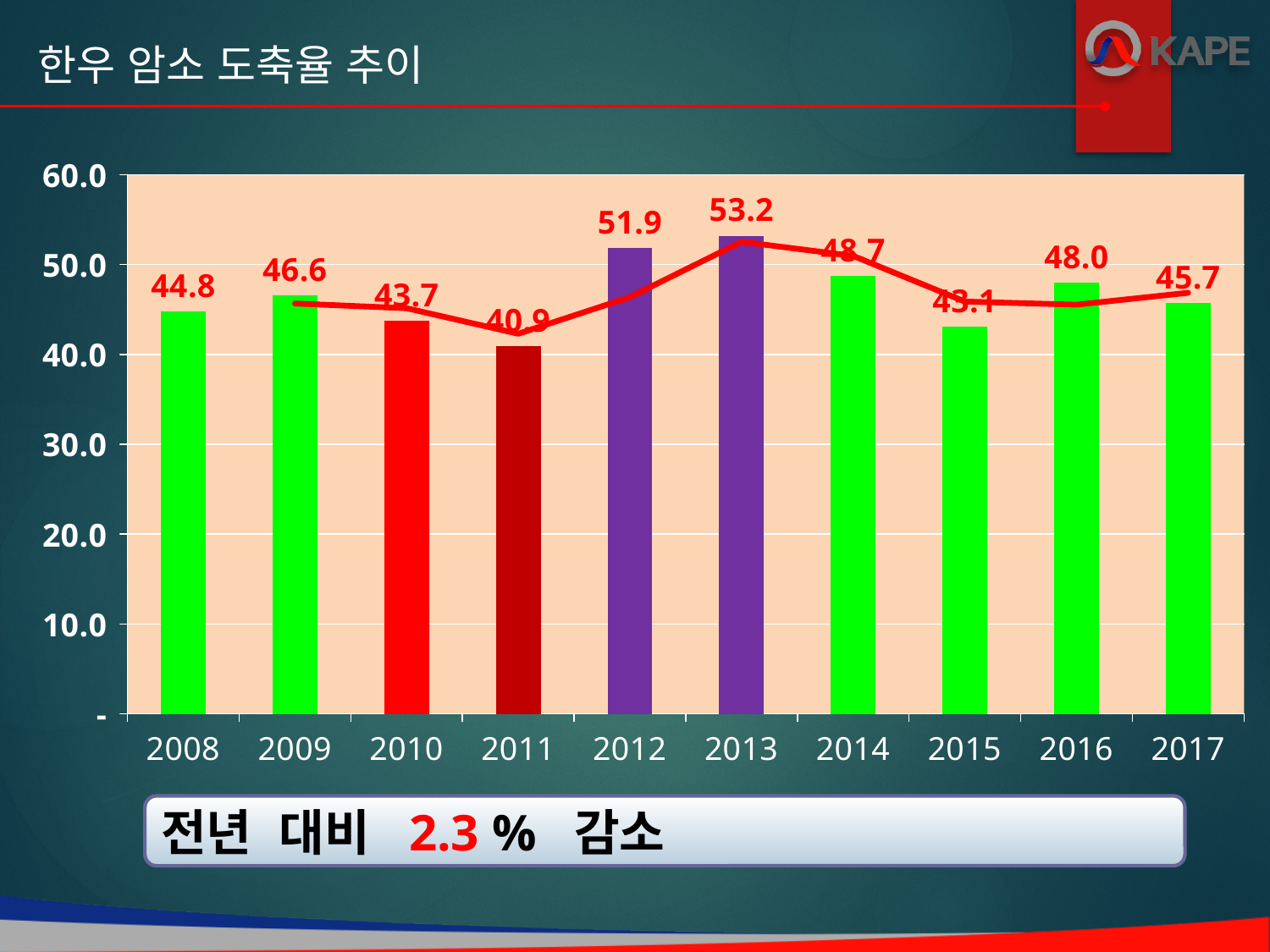
What is the title of the chart? 한우 암소 도축율 추이 What kind of chart is this? bar chart What is the value for 2008? 44.8 Which year has the highest value? 2013 What is the difference between the values for 2016 and 2017? 2.3 What is the value for 2017? 45.7 What is the value for 2013? 53.2 Which year has the lowest value? 2011 How many years are shown on the x axis? 10 What is the difference between the values for 2013 and 2011? 12.3 Which is larger, the value for 2012 or the value for 2014? 2012 Is the value for 2011 greater or less than 50.0? less